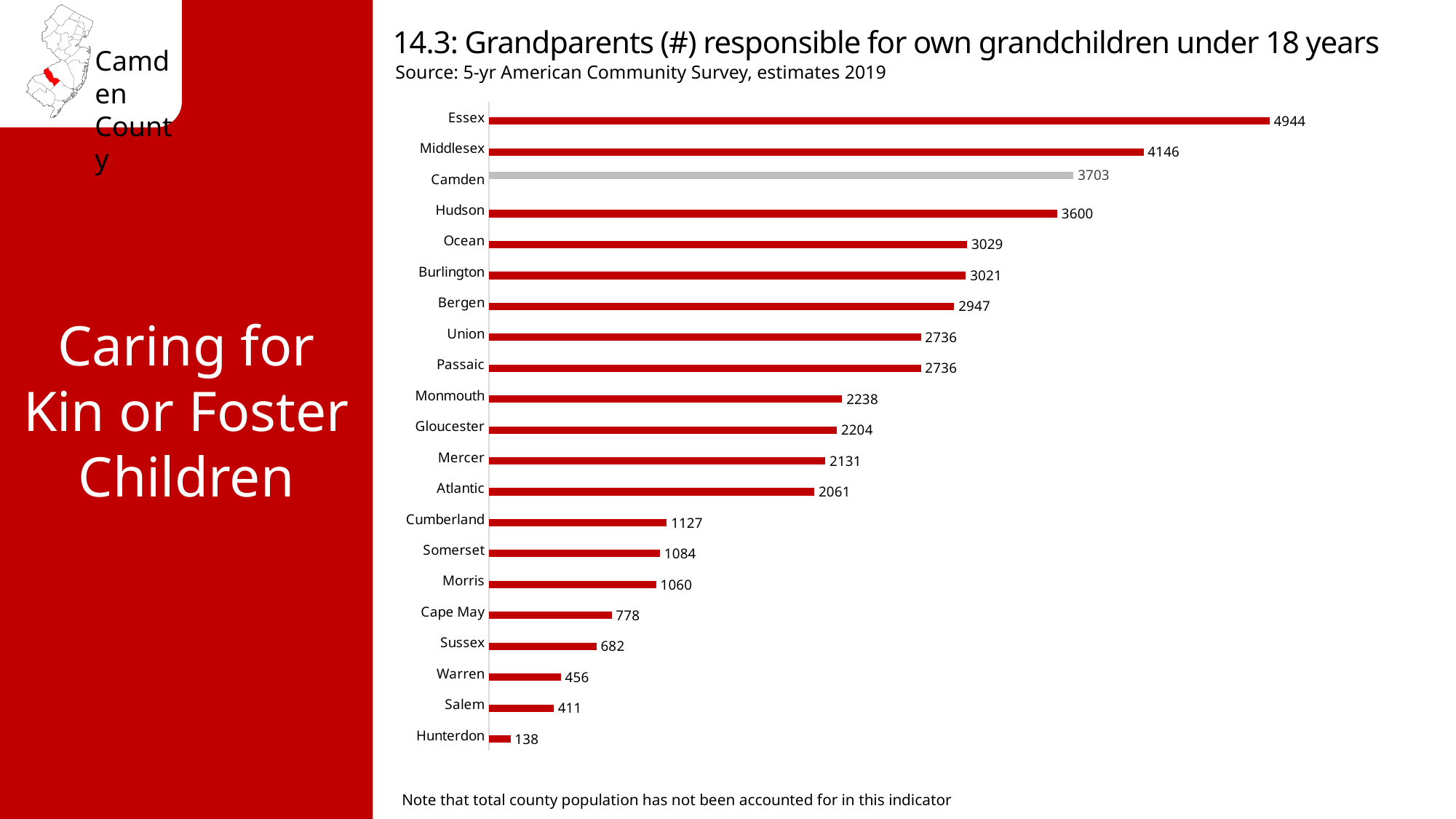
Which has a larger value, Monmouth or Atlantic? Monmouth Which has a larger value, Cumberland or Cape May? Cumberland Which county has the lowest value on the chart? Hunterdon What kind of chart is shown on the slide? Bar chart What is the number of grandparents responsible for own grandchildren in Camden? 3703 Which county's bar is shown in grey rather than red? Camden Which county has the highest number of grandparents responsible for own grandchildren? Essex How many counties are shown on the chart? 21 What is the value shown for Hudson? 3600 What is the difference between the values for Camden and Gloucester? 1499 What is the difference between the values for Essex and Middlesex? 798 What is the value shown for Hunterdon? 138